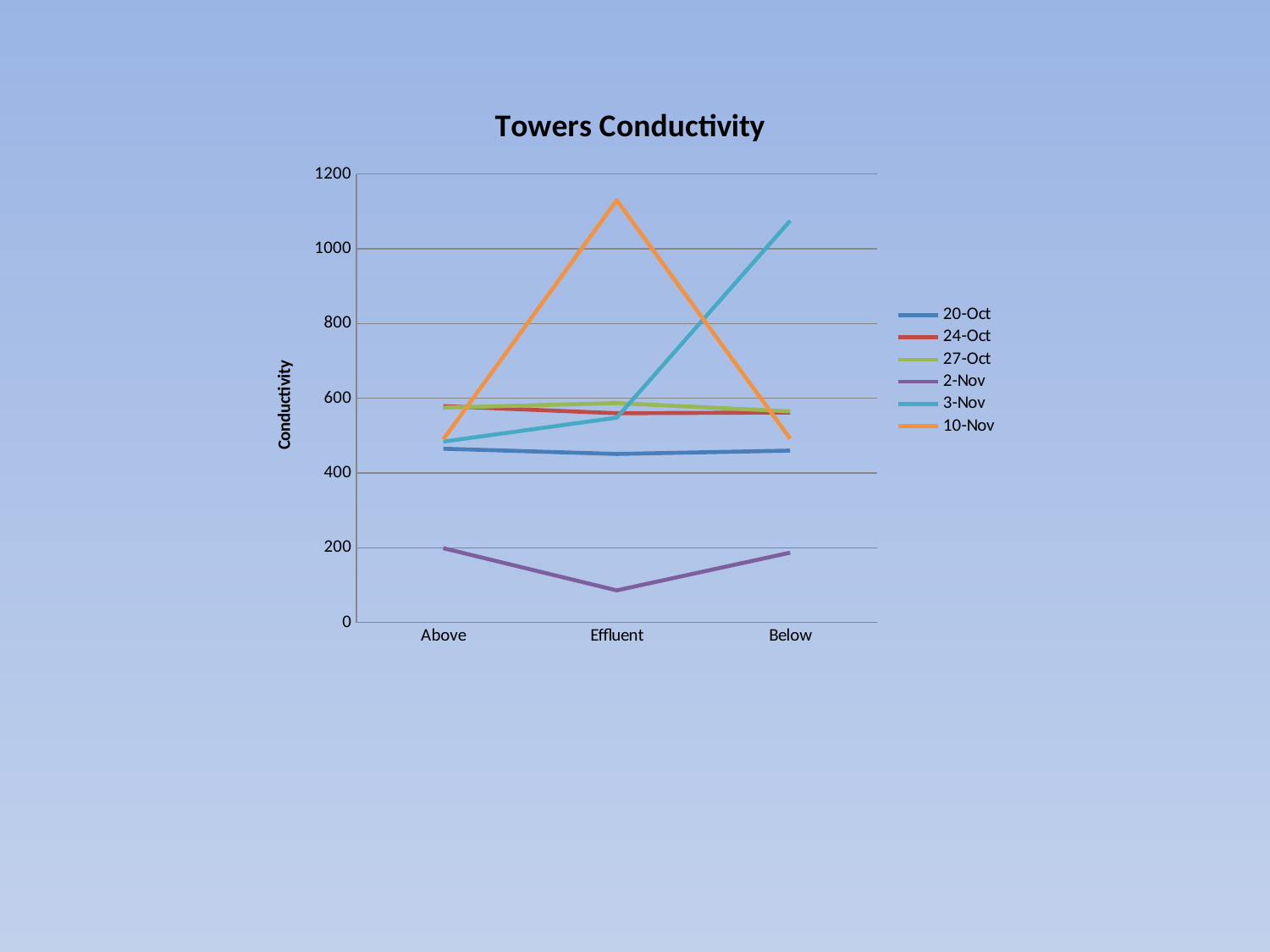
Is the value for 10-Nov at Effluent greater or less than 1000? greater Does the 3-Nov series rise or fall from Above to Below? rise What is the title of the chart? Towers Conductivity What is the label on the vertical axis of the chart? Conductivity Is the value for 2-Nov at Effluent greater or less than 200? less Which series has the lowest value at Above? 2-Nov How many categories are shown on the x axis of the Towers Conductivity chart? 3 Which series has the highest value at Effluent? 10-Nov Is the value for 3-Nov at Below greater or less than 1000? greater What kind of chart is shown on the slide? line chart How many series does the legend of the Towers Conductivity chart list? 6 At Below, which series has the larger value, 3-Nov or 20-Oct? 3-Nov